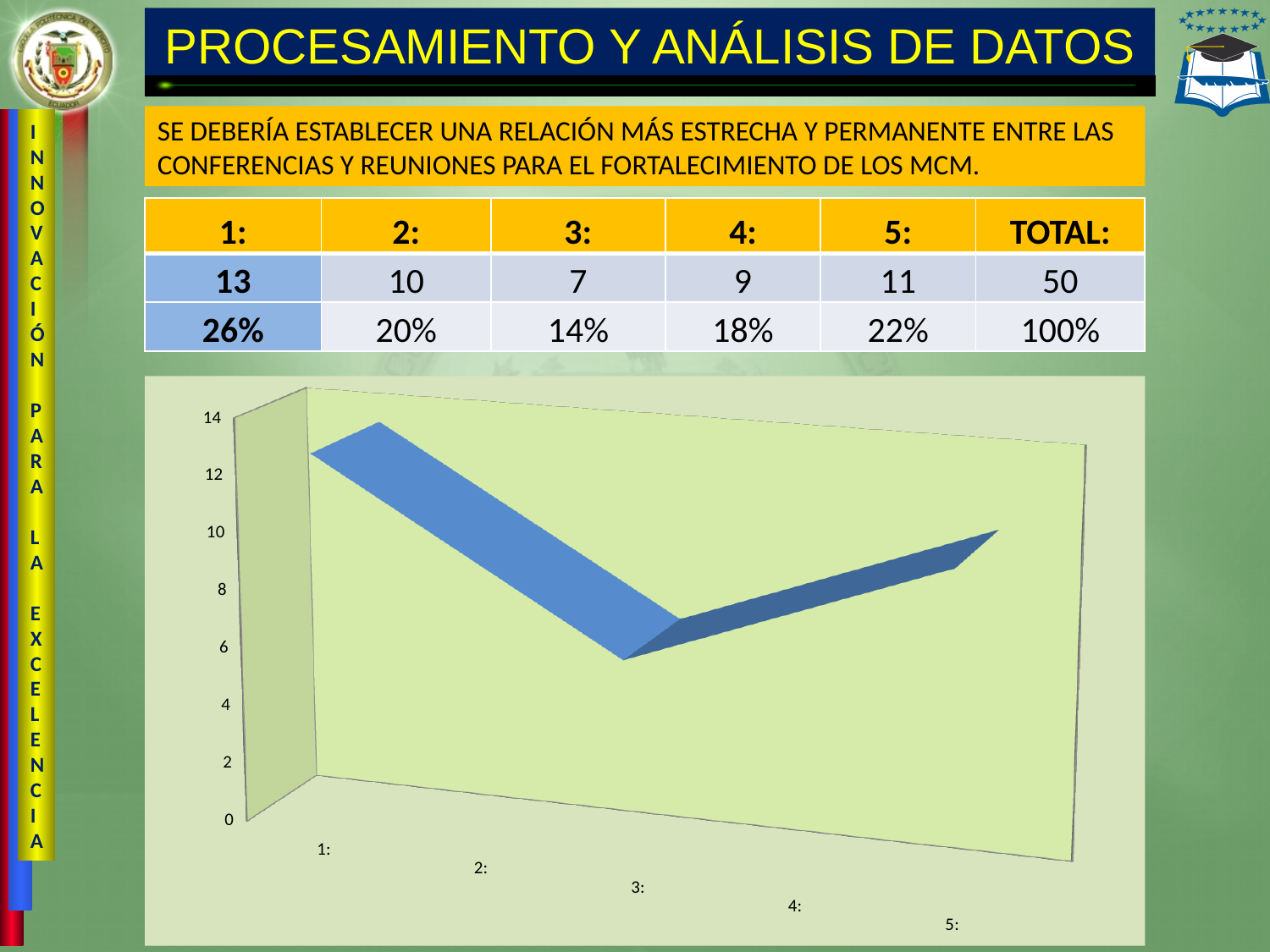
What kind of chart is shown on the slide? line chart Which is larger, the value for category 2: or the value for category 4:? 2: Is the value for category 1: in the chart greater or less than 12? greater Which category has the highest value in the chart? 1: What is the difference between the values for category 1: and category 3: shown in the table? 6 According to the table, what is the value for category 3:? 7 According to the table, what is the value for category 1:? 13 According to the table, what percentage corresponds to category 5:? 22% Is the value for category 3: in the chart greater or less than 8? less Do the values fall or rise from category 1: to category 3: in the chart? fall Which category has the lowest value in the chart? 3: How many categories are plotted along the x axis of the chart? 5